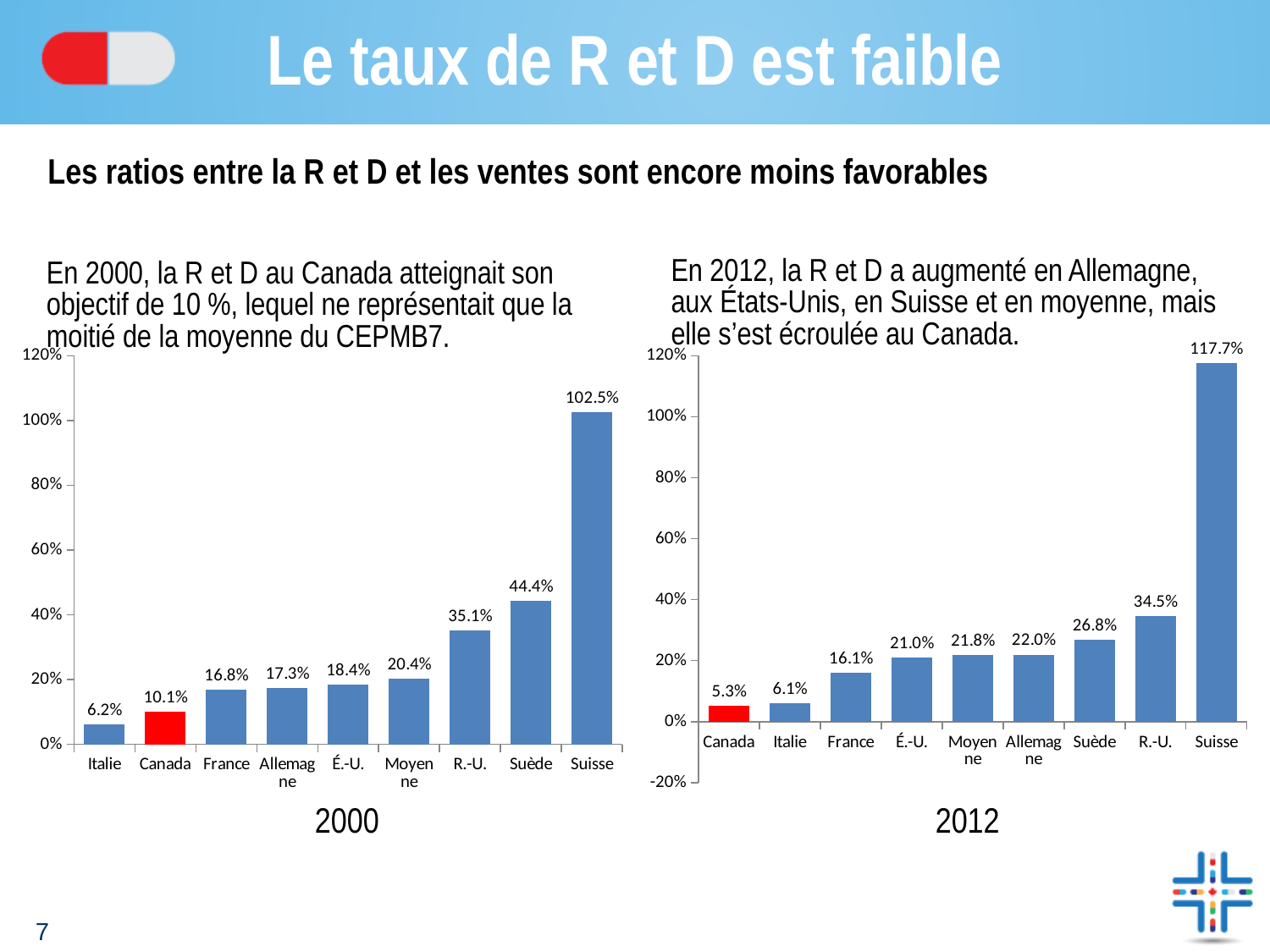
In the 2012 chart, which bar is coloured red? Canada In the 2012 chart, what is the value for Moyenne? 21.8% What kind of chart is the 2012 chart? Bar chart How many categories are shown in the 2000 chart? 9 In the 2012 chart, what is the value for Suisse? 117.7% In the 2000 chart, which category has the highest value? Suisse In the 2012 chart, which is larger, the value for R.-U. or the value for Suède? R.-U. In the 2000 chart, what is the difference between the values for Suède and R.-U.? 9.3% In the 2012 chart, which category has the lowest value? Canada In the 2012 chart, what is the difference between the values for Italie and Canada? 0.8% In the 2000 chart, what is the value for Canada? 10.1% In the 2000 chart, which category has the lowest value? Italie